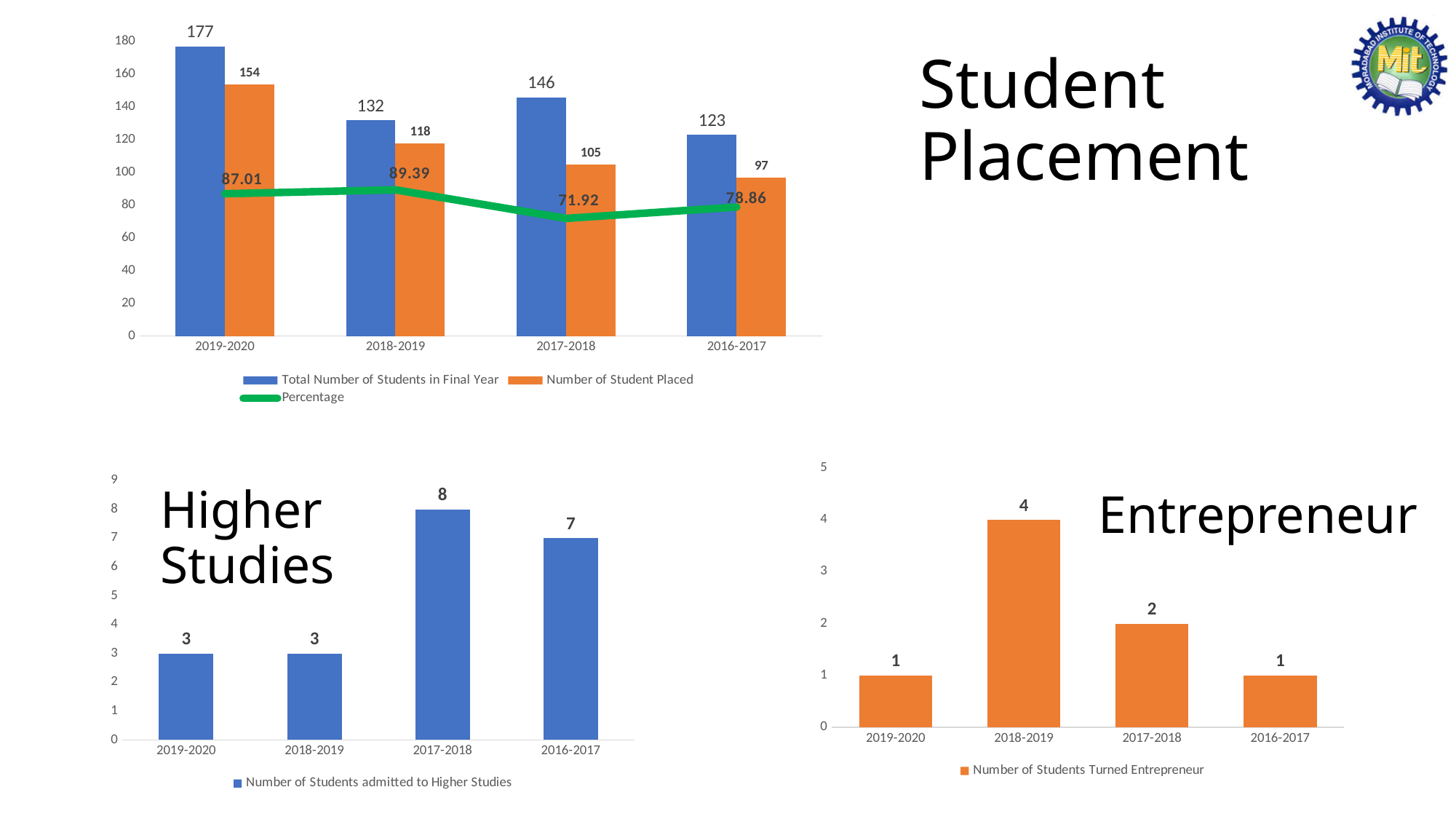
In the Student Placement chart, what is the Percentage value for 2018-2019? 89.39 How many categories are shown on the x axis of the Higher Studies chart? 4 In the Student Placement chart, what is the Total Number of Students in Final Year for 2019-2020? 177 What kind of chart is the Entrepreneur chart? bar chart In the Entrepreneur chart, what is the Number of Students Turned Entrepreneur for 2018-2019? 4 How many series does the legend of the Student Placement chart list? 3 In the Student Placement chart, what is the difference between the Total Number of Students in Final Year and the Number of Student Placed for 2016-2017? 26 In the Student Placement chart, which year has the lowest Percentage value? 2017-2018 In the Student Placement chart, what is the Number of Student Placed for 2017-2018? 105 In the Entrepreneur chart, is the value for 2017-2018 larger or smaller than the value for 2016-2017? larger In the Higher Studies chart, which year has the highest number of students admitted to Higher Studies? 2017-2018 In the Higher Studies chart, what is the value for 2017-2018? 8